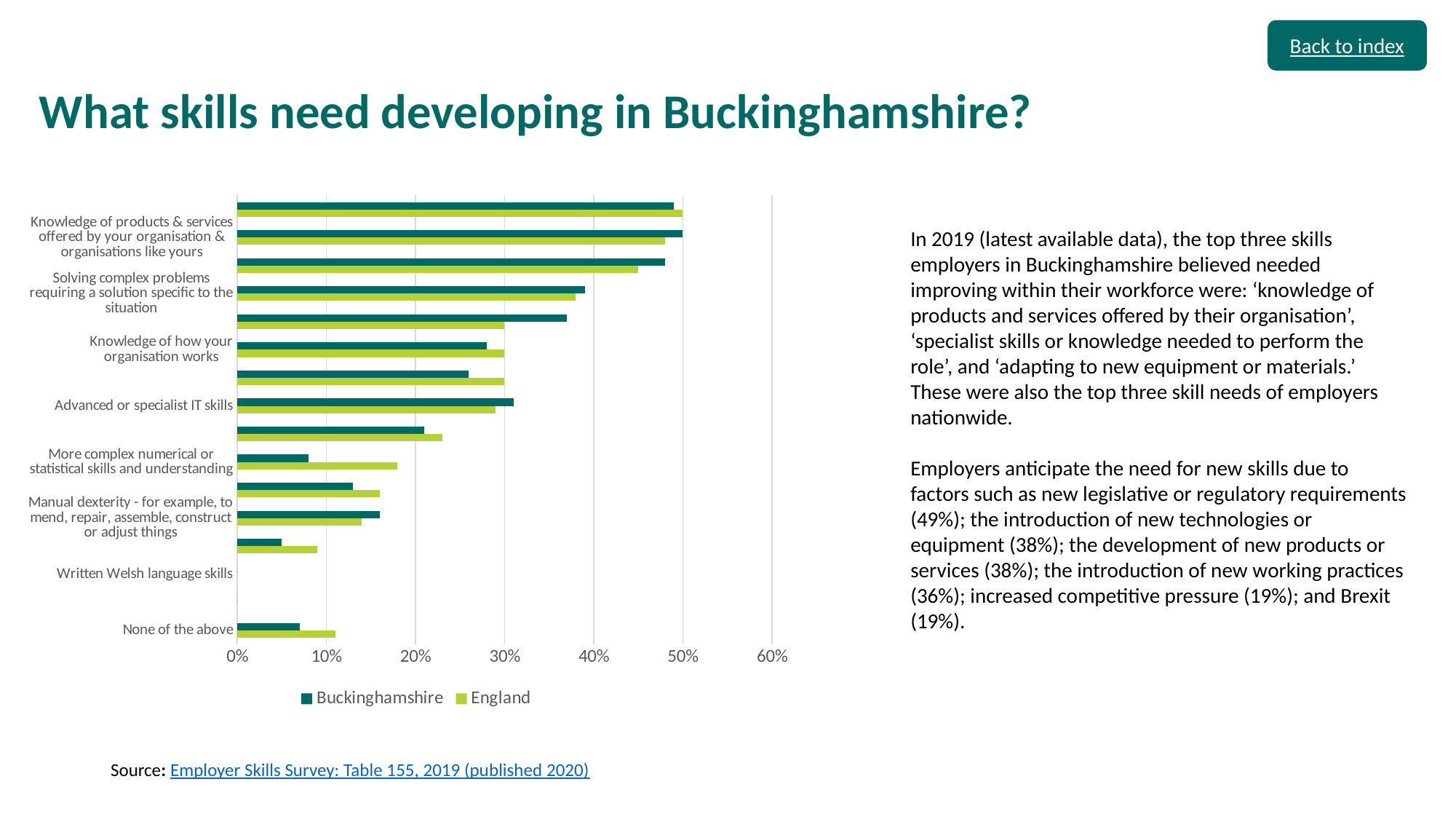
What is the highest value shown on the chart's percentage axis? 60% How many series does the chart legend list? 2 Is the England value for 'None of the above' greater or less than 20%? less Is the Buckinghamshire value for 'Manual dexterity - for example, to mend, repair, assemble, construct or adjust things' greater or less than 20%? less For 'More complex numerical or statistical skills and understanding', which is larger: the Buckinghamshire value or the England value? England Which labelled category has the lowest Buckinghamshire value? Written Welsh language skills Is the Buckinghamshire value for 'Advanced or specialist IT skills' greater or less than 20%? greater For 'None of the above', which is larger: the Buckinghamshire value or the England value? England What are the two series named in the chart legend? Buckinghamshire and England What kind of chart is shown on the slide? Bar chart